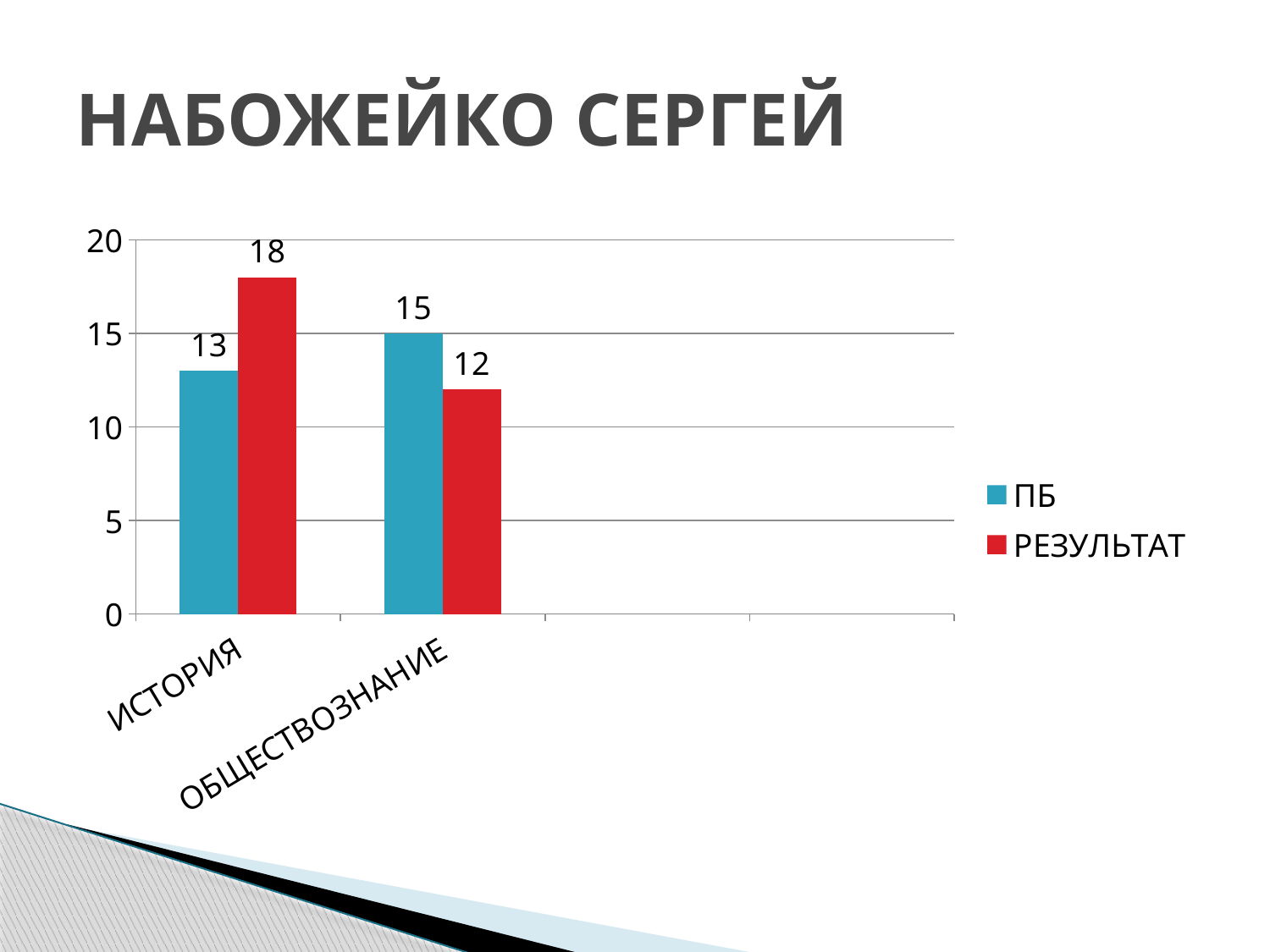
What kind of chart is shown on the slide? Bar chart What is the РЕЗУЛЬТАТ value for ОБЩЕСТВОЗНАНИЕ? 12 What is the РЕЗУЛЬТАТ value for ИСТОРИЯ? 18 What is the difference between the РЕЗУЛЬТАТ and ПБ values for ИСТОРИЯ? 5 Which category has the lowest ПБ value? ИСТОРИЯ How many series does the legend list? 2 What is the difference between the ПБ and РЕЗУЛЬТАТ values for ОБЩЕСТВОЗНАНИЕ? 3 Which category has the highest РЕЗУЛЬТАТ value? ИСТОРИЯ How many categories are shown on the x axis? 2 What is the ПБ value for ИСТОРИЯ? 13 For ОБЩЕСТВОЗНАНИЕ, which is larger: ПБ or РЕЗУЛЬТАТ? ПБ What is the ПБ value for ОБЩЕСТВОЗНАНИЕ? 15